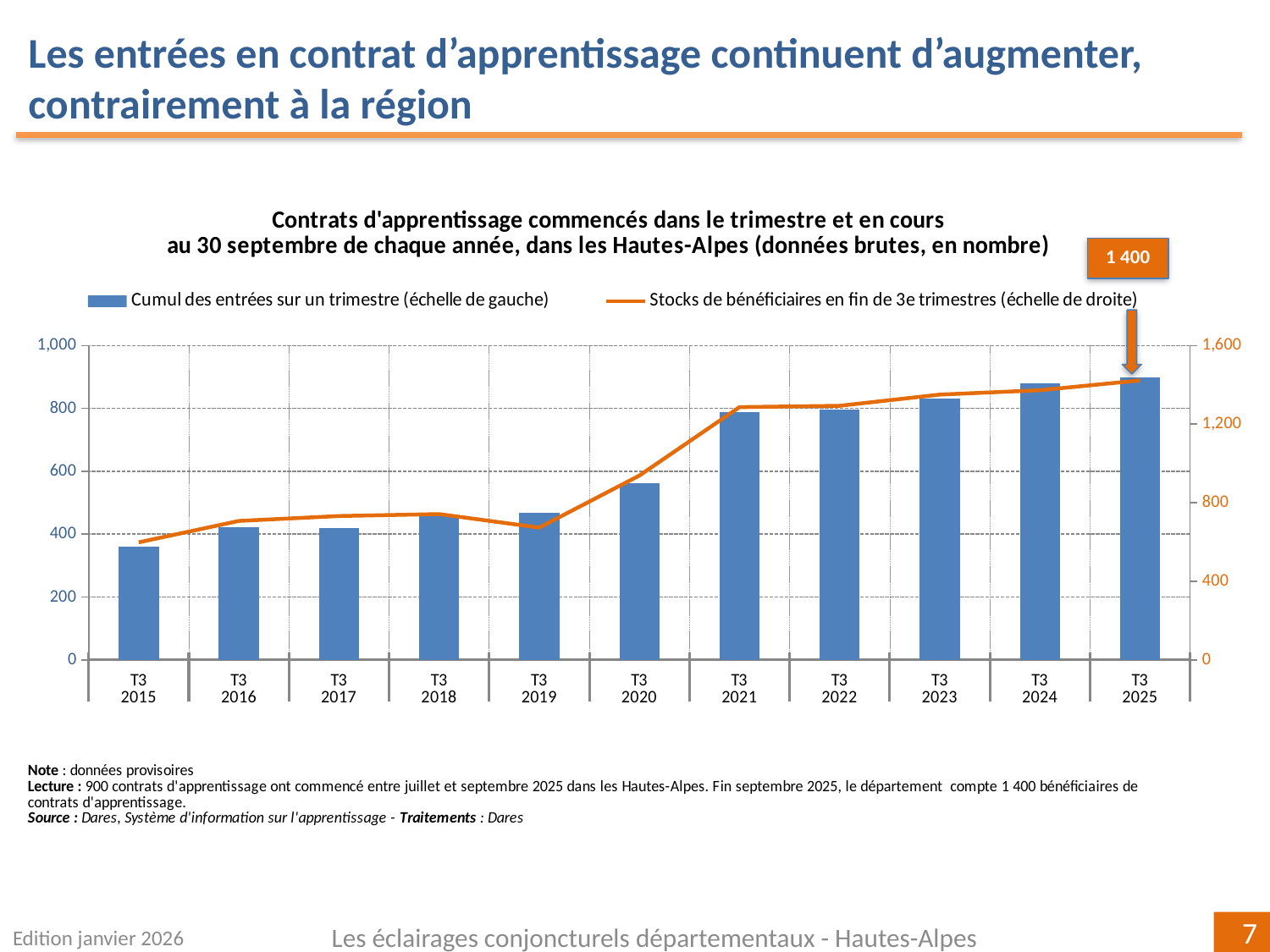
How many series does the legend list? 2 Is the bar value for T3 2015 greater or less than 400? less Which has the larger bar value: T3 2019 or T3 2021? T3 2021 Is the bar value for T3 2020 greater or less than 600? less What kind of chart is shown on the slide? A combined bar and line chart What is the value of 'Stocks de bénéficiaires en fin de 3e trimestres' at T3 2025, as shown in the callout? 1 400 Which quarter has the lowest bar for 'Cumul des entrées sur un trimestre'? T3 2015 What is the legend label of the blue bar series? Cumul des entrées sur un trimestre (échelle de gauche) Which quarter has the highest bar for 'Cumul des entrées sur un trimestre'? T3 2025 Does the 'Stocks de bénéficiaires' line rise or fall overall from T3 2015 to T3 2025? rises Which has the larger bar value: T3 2018 or T3 2024? T3 2024 How many quarters (T3 points) are shown along the x axis? 11